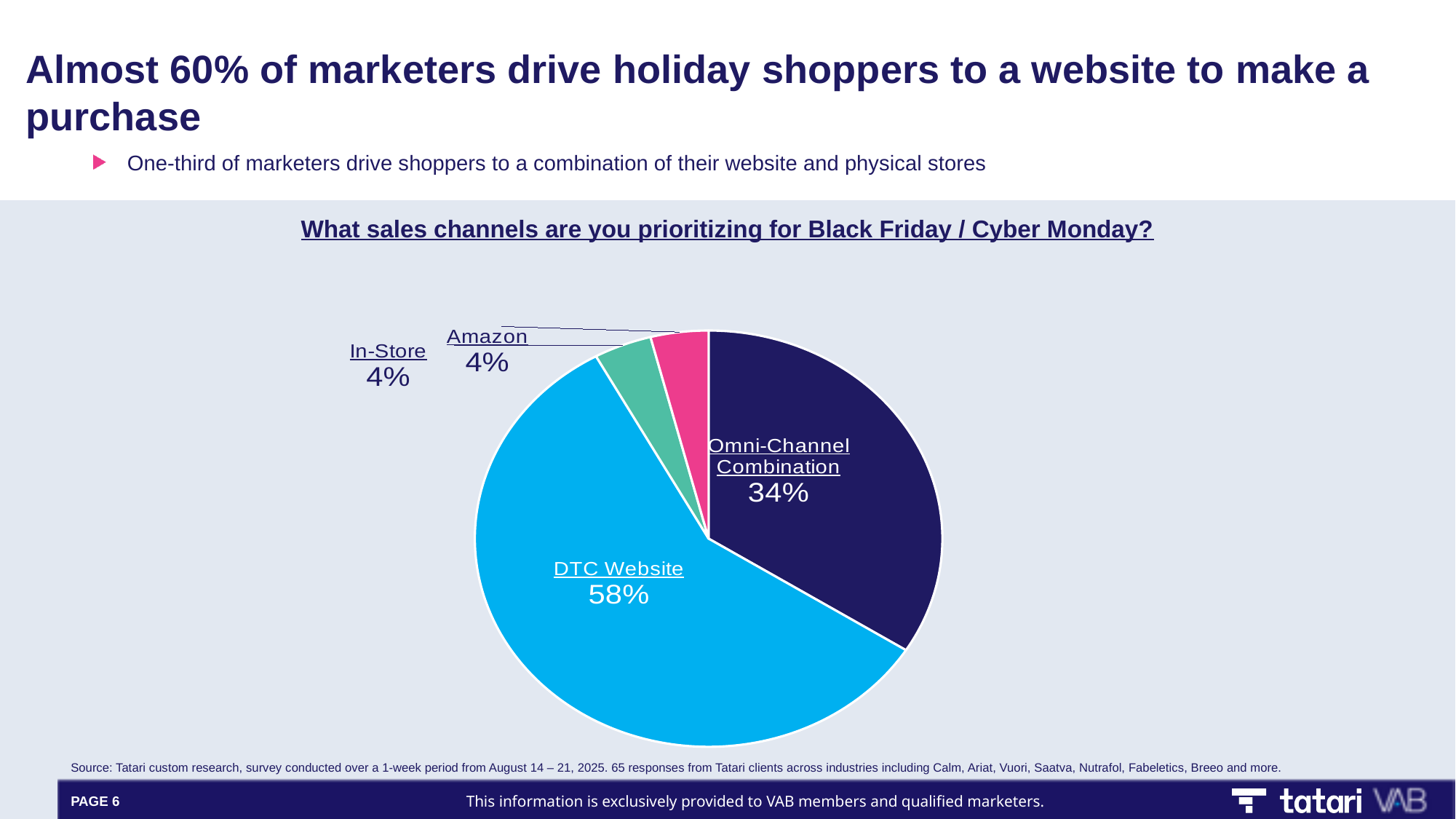
What is the difference in percentage points between DTC Website and Omni-Channel Combination? 24 percentage points What type of chart is shown on the slide? Pie chart What share of marketers are prioritizing an Omni-Channel Combination? 34% Which sales channel has the largest slice of the pie? DTC Website What is the combined share of the Amazon and In-Store slices? 8% Which is larger, the Omni-Channel Combination slice or the Amazon slice? Omni-Channel Combination How many slices does the pie chart have? 4 What share of marketers are prioritizing the DTC Website channel? 58% What share of marketers are prioritizing In-Store? 4% What share of marketers are prioritizing Amazon? 4% What is the title of the chart? What sales channels are you prioritizing for Black Friday / Cyber Monday? What colour is the DTC Website slice? Light blue